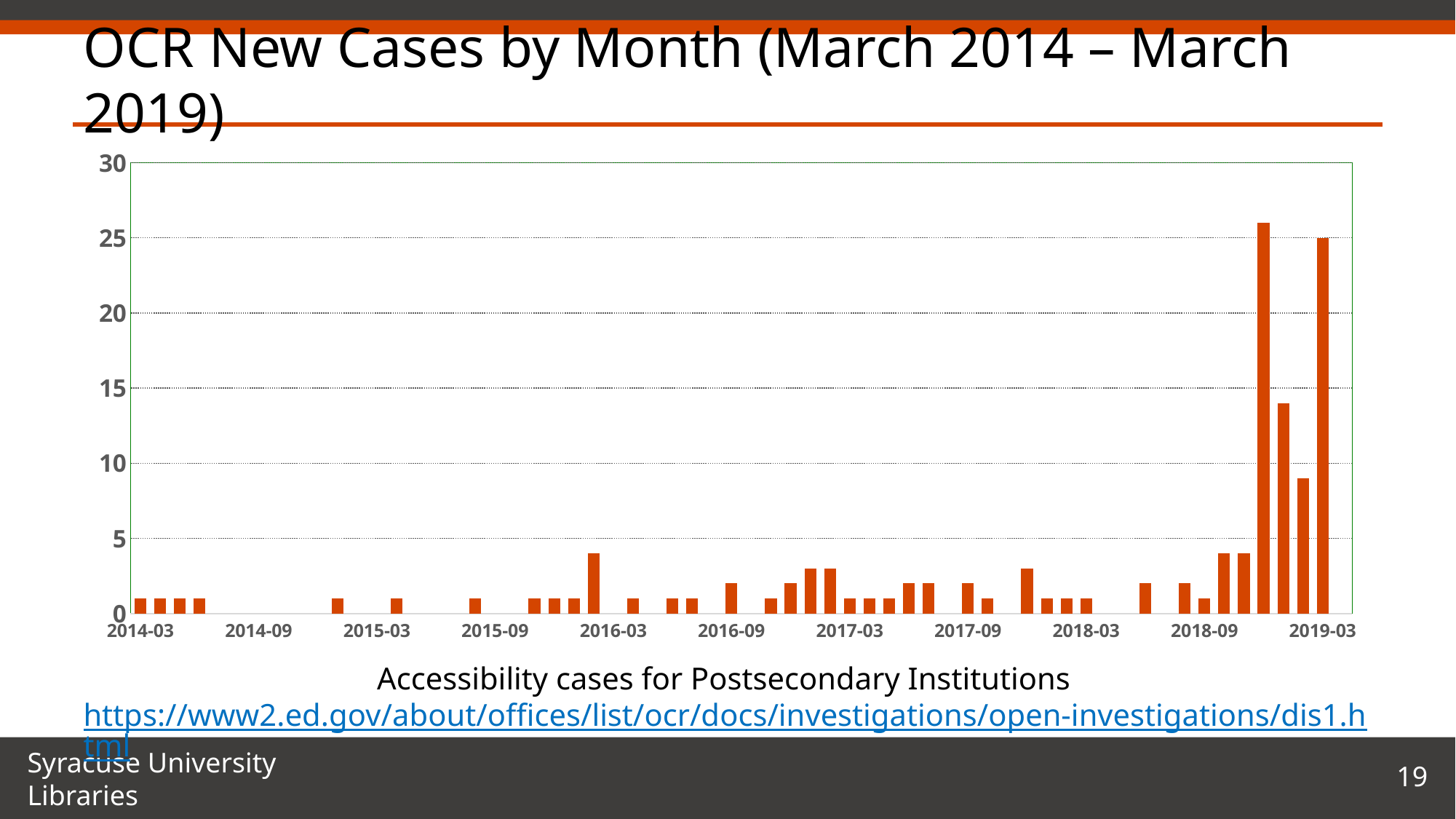
Is the value for 2017-03 greater or less than 5? less Is the value for 2019-03 greater or less than 20? greater Is the value for 2018-03 greater or less than 10? less What is the title of the chart? OCR New Cases by Month (March 2014 – March 2019) What is the highest value shown on the y axis? 30 How many month labels are shown on the x axis? 11 What kind of chart is shown on the slide? bar chart Of the months labeled on the x axis, which has the tallest bar? 2019-03 Do the values generally rise or fall toward the right end of the x axis? rise Which has the larger value, 2019-03 or 2014-03? 2019-03